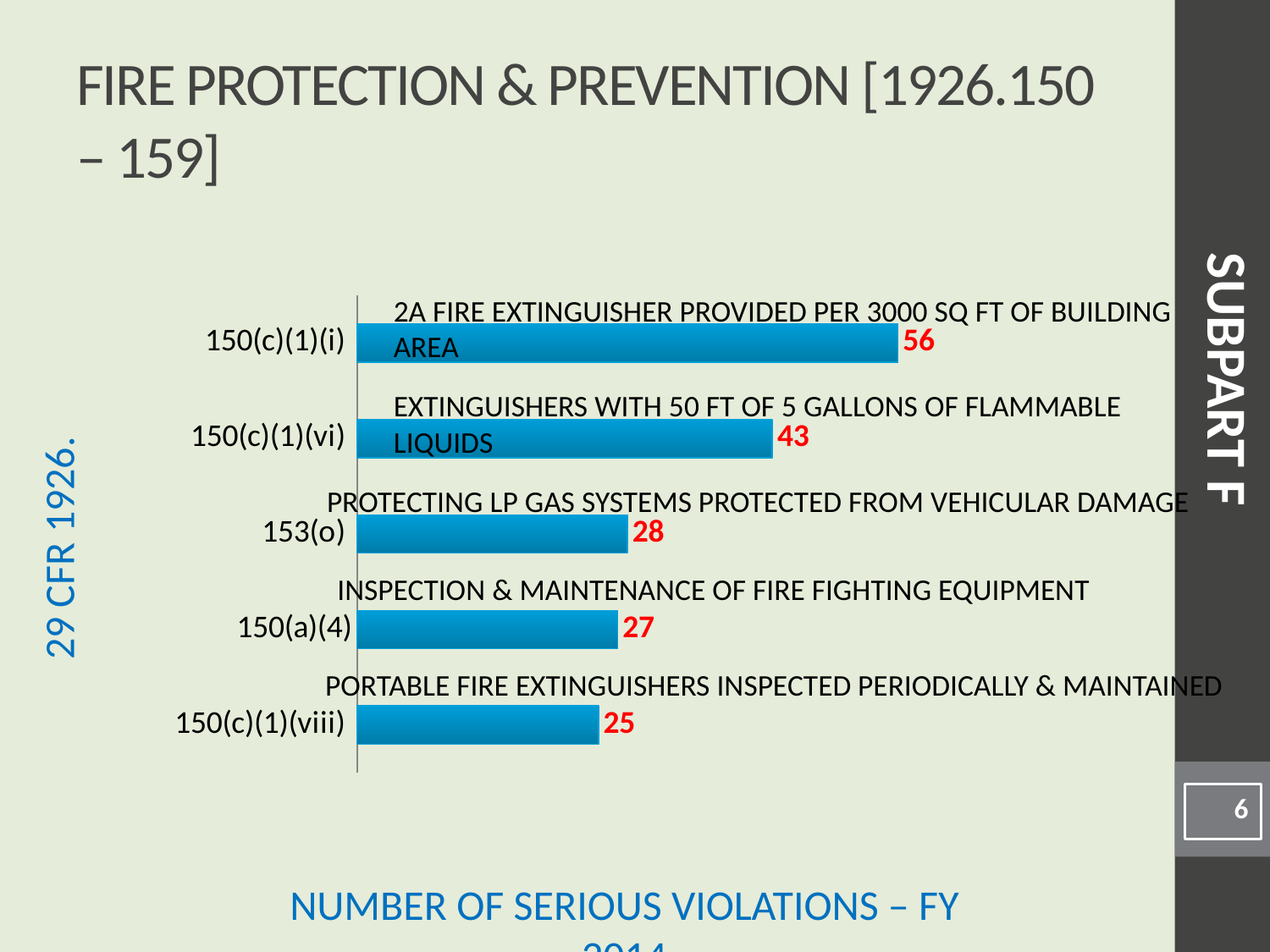
What is the value shown for 150(c)(1)(viii)? 25 What is the difference between the values for 153(o) and 150(c)(1)(viii)? 3 How many categories are shown in the chart? 5 What is the number of serious violations for 150(c)(1)(i)? 56 Which category has the highest number of serious violations? 150(c)(1)(i) What is the number of serious violations for 153(o)? 28 What kind of chart is shown on the slide? Bar chart What is the difference between the values for 150(c)(1)(i) and 150(c)(1)(vi)? 13 Which category has the lowest number of serious violations? 150(c)(1)(viii) What is the total number of serious violations across all five categories? 179 Which has more serious violations, 150(c)(1)(vi) or 150(a)(4)? 150(c)(1)(vi)